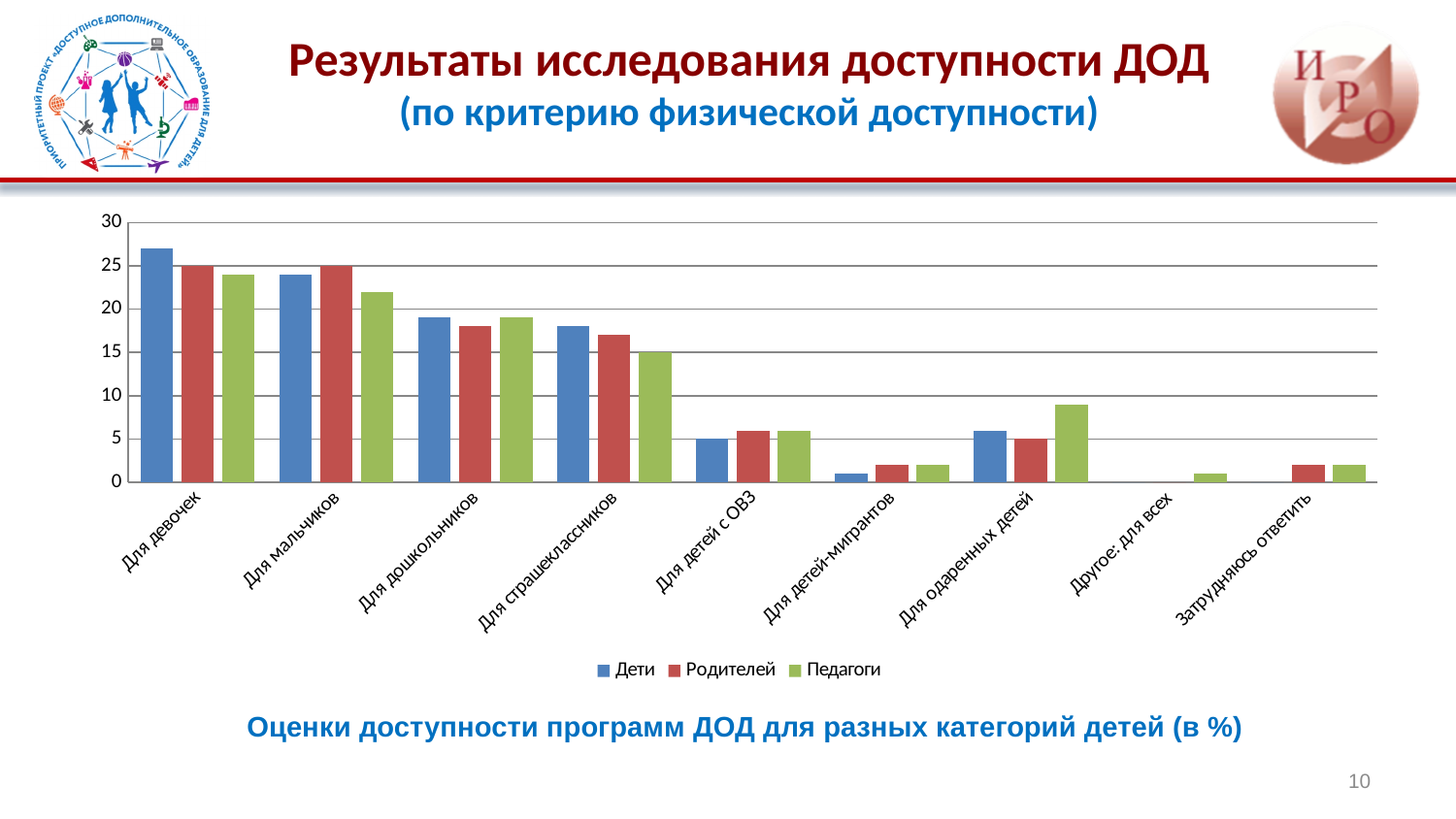
Is the value for Дети in the category Для детей-мигрантов greater or less than 5? less How many series does the legend list? 3 How many categories are shown on the x axis? 9 What kind of chart is shown on the slide? bar chart For the Педагоги series, which category has the larger value: Для девочек or Для мальчиков? Для девочек Do the values for the Дети series generally rise or fall from left to right across the categories? fall What are the three series listed in the legend? Дети, Родителей, Педагоги Is the value for Педагоги in the category Для одаренных детей greater or less than 5? greater What is the value for Дети in the category Для детей с ОВЗ? 5 Is the value for Дети in the category Для девочек greater or less than 25? greater Which category has the highest value for the Дети series? Для девочек In the category Для одаренных детей, which series has the larger value: Дети or Педагоги? Педагоги